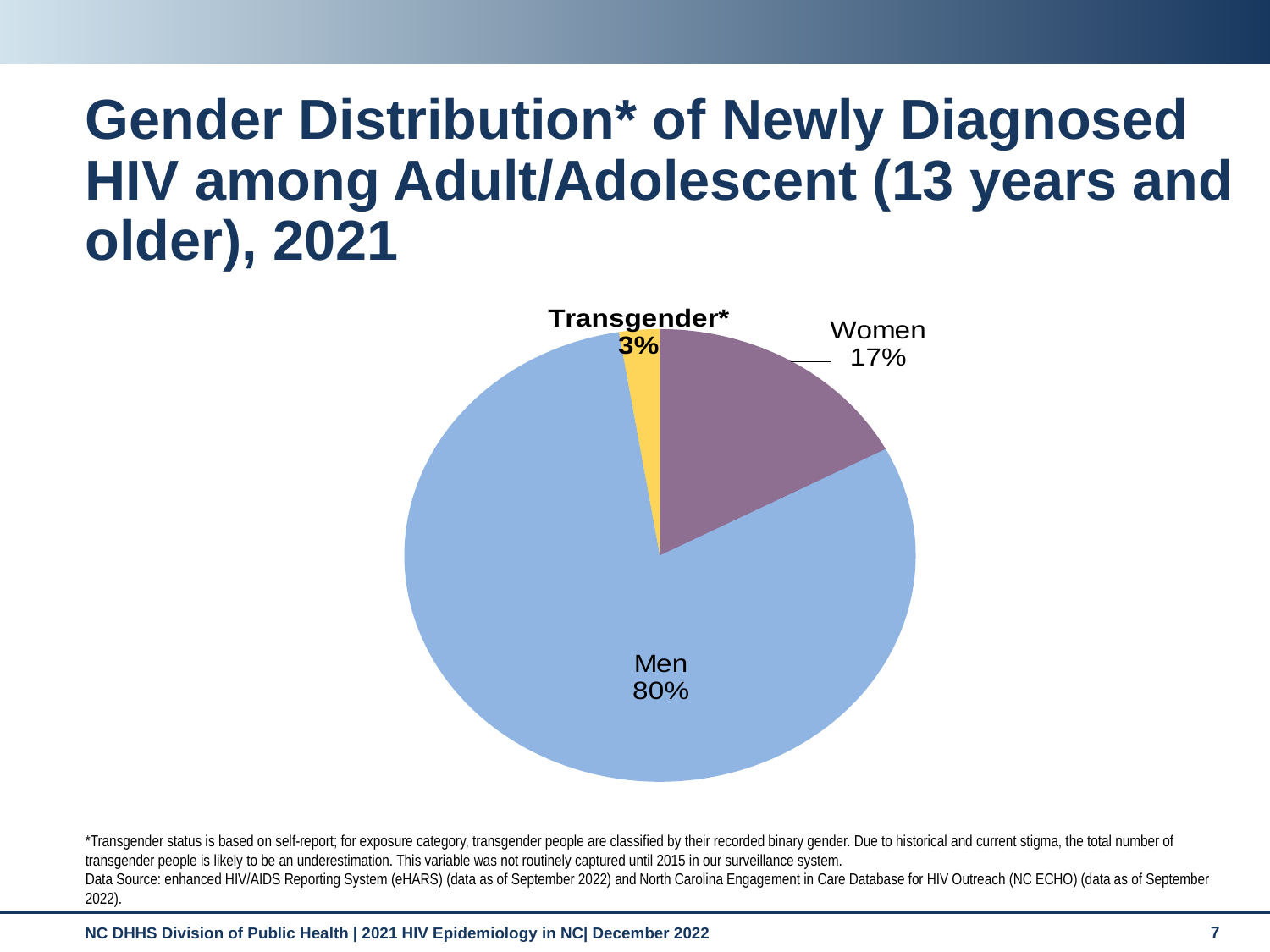
What colour is the Transgender* slice of the pie? Yellow Which slice is larger, Women or Transgender*? Women What share of the pie is Transgender*? 3% What colour is the Men slice of the pie? Light blue Which category has the largest slice of the pie? Men What share of the pie is Men? 80% How many slices does the pie chart have? 3 What is the difference in percentage points between the Men and Women slices? 63 What kind of chart is shown on the slide? Pie chart Which category has the smallest slice of the pie? Transgender* What share of the pie is Women? 17% What is the difference in percentage points between the Women and Transgender* slices? 14